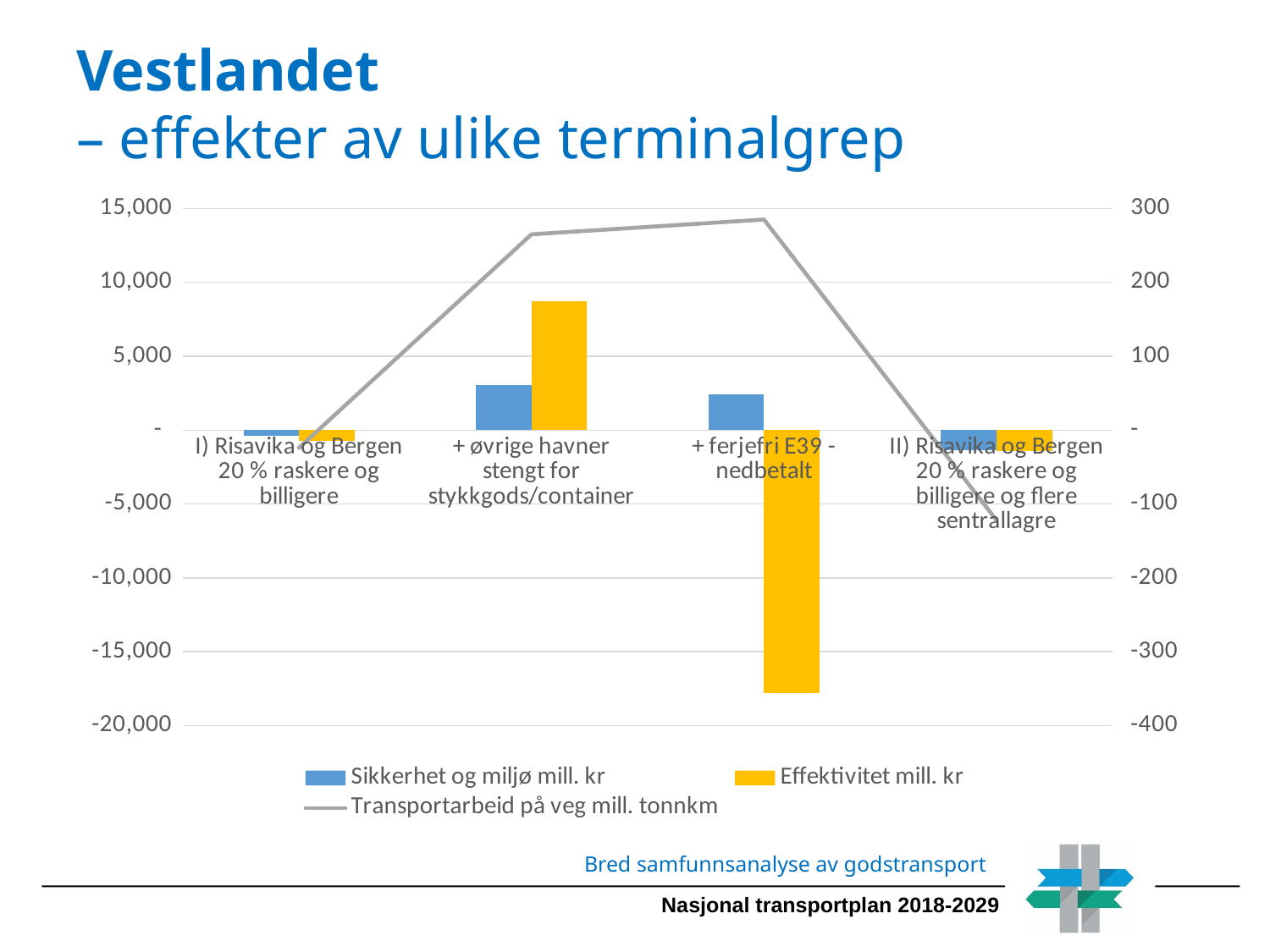
Which category has the highest value for Effektivitet mill. kr? + øvrige havner stengt for stykkgods/container What kind of chart is shown on the slide? A combined bar and line chart Which category has the highest value for Transportarbeid på veg mill. tonnkm? + ferjefri E39 - nedbetalt Is the Effektivitet mill. kr value for '+ øvrige havner stengt for stykkgods/container' greater or less than 5,000? greater Which category has the highest value for Sikkerhet og miljø mill. kr? + øvrige havner stengt for stykkgods/container Which series is plotted as a line rather than bars? Transportarbeid på veg mill. tonnkm Is the Effektivitet mill. kr value for '+ ferjefri E39 - nedbetalt' greater or less than -15,000? less How many series does the chart legend list? 3 Which category has the lowest value for Effektivitet mill. kr? + ferjefri E39 - nedbetalt For '+ ferjefri E39 - nedbetalt', which is larger: Sikkerhet og miljø mill. kr or Effektivitet mill. kr? Sikkerhet og miljø mill. kr Is the Transportarbeid på veg mill. tonnkm value for '+ ferjefri E39 - nedbetalt' greater or less than 200? greater How many categories are shown along the x axis of the chart? 4